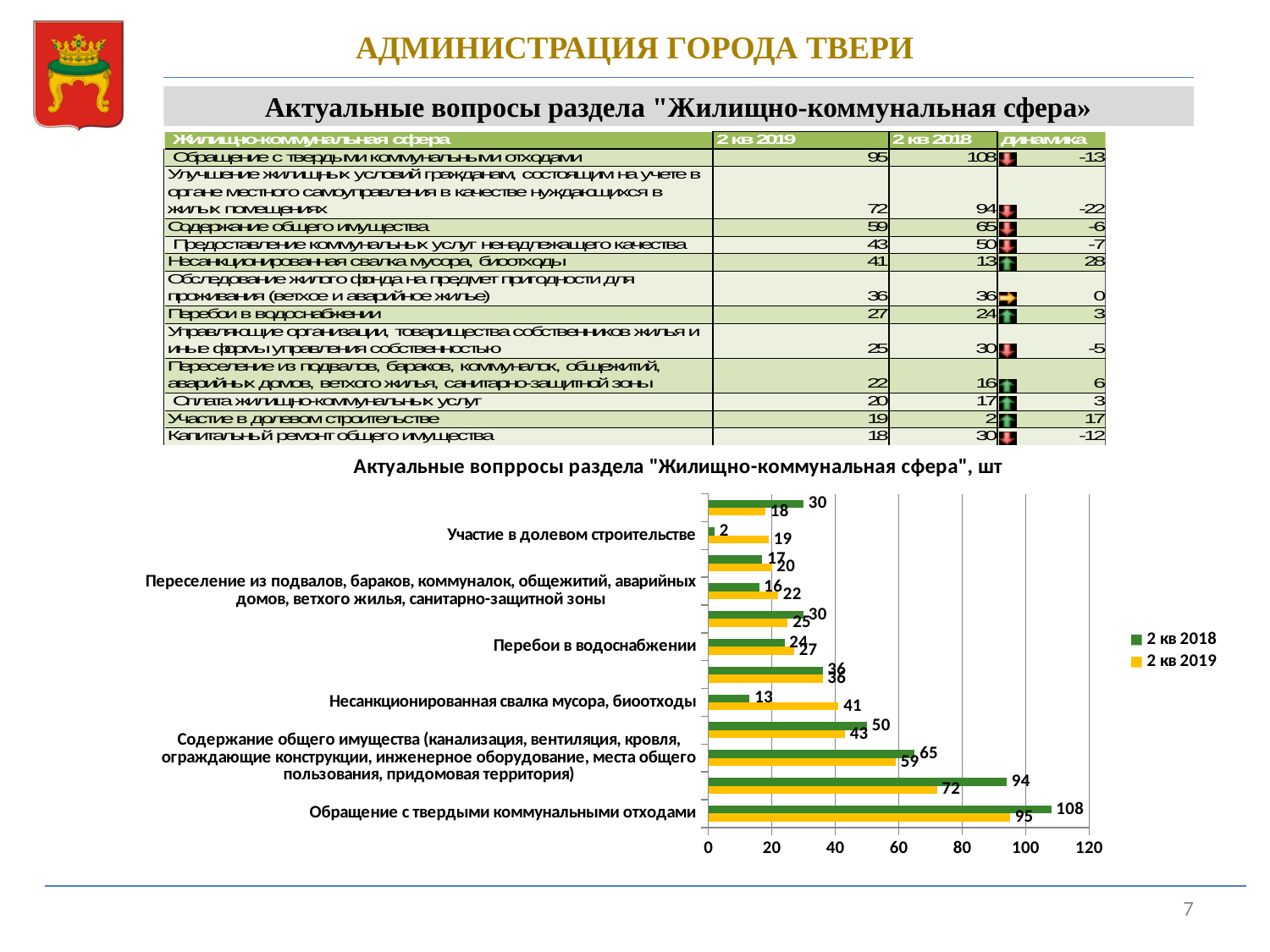
Which category has the highest value for 2 кв 2019 in the chart? Обращение с твердыми коммунальными отходами What is the value for 2 кв 2018 for "Участие в долевом строительстве" in the chart? 2 What is the value for 2 кв 2018 for "Обращение с твердыми коммунальными отходами" in the chart? 108 What is the difference between the 2 кв 2018 and 2 кв 2019 values for "Несанкционированная свалка мусора, биоотходы"? 28 What is the value for 2 кв 2019 for "Обращение с твердыми коммунальными отходами" in the chart? 95 How many series does the chart legend list? 2 What kind of chart is shown on the slide? bar chart Which colour represents the 2 кв 2019 series in the chart? yellow What is the value for 2 кв 2019 for "Несанкционированная свалка мусора, биоотходы" in the chart? 41 Is the 2 кв 2018 value for "Содержание общего имущества" greater or less than 60? greater How many categories (pairs of bars) are plotted in the chart? 12 For "Перебои в водоснабжении", which series has the larger value, 2 кв 2018 or 2 кв 2019? 2 кв 2019